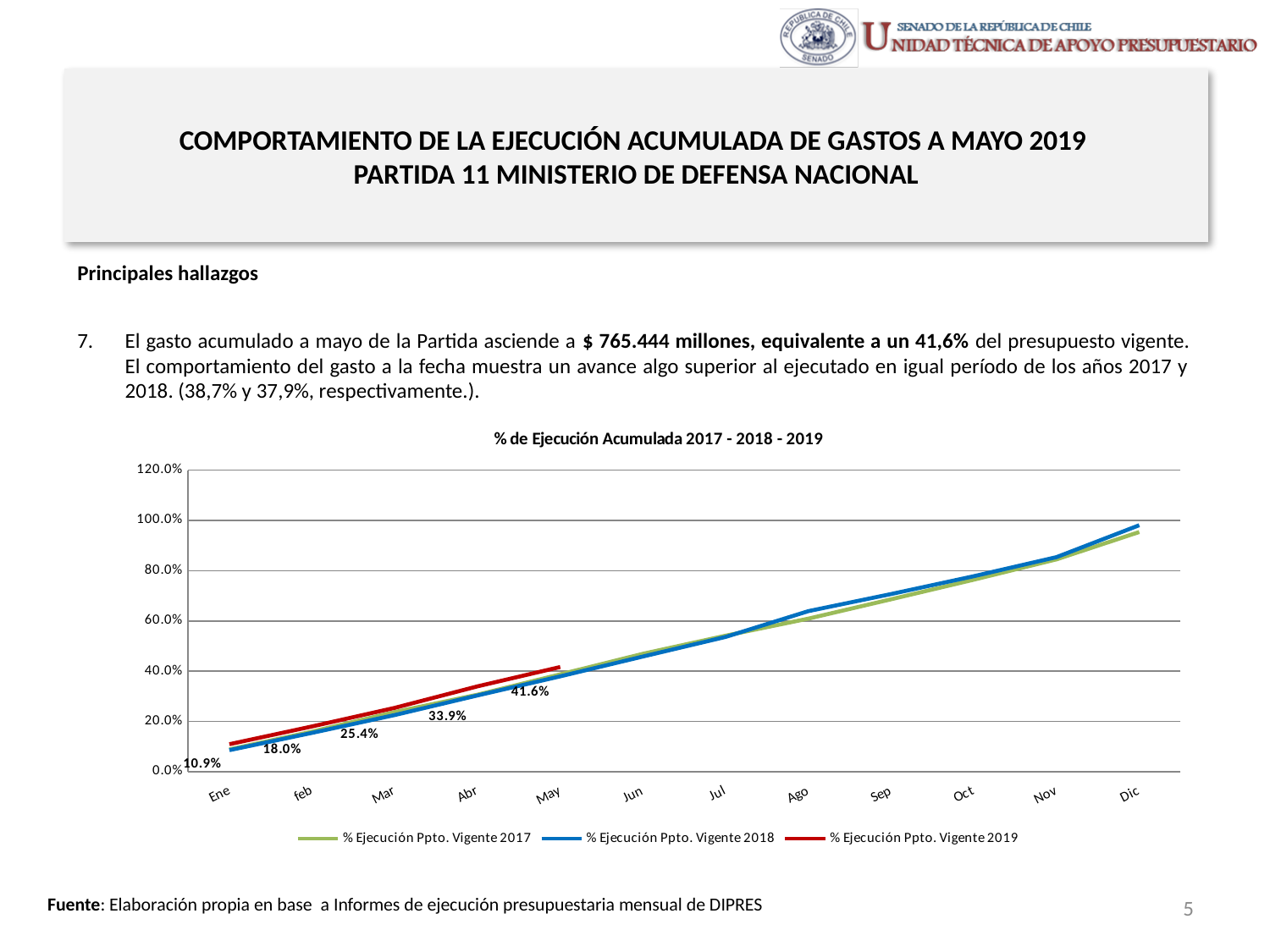
What is the value of % Ejecución Ppto. Vigente 2019 for Mar? 25.4% What is the difference between the 2019 values for Abr and Mar? 8.5% What is the difference between the 2019 values for May and Ene? 30.7% What is the title of the chart? % de Ejecución Acumulada 2017 - 2018 - 2019 How many months are shown on the x axis? 12 Does the % Ejecución Ppto. Vigente 2018 series rise or fall from Ene to Dic? rise What is the value of % Ejecución Ppto. Vigente 2019 for Ene? 10.9% What kind of chart is shown on the slide? line chart Is the value for % Ejecución Ppto. Vigente 2018 in Dic greater or less than 80%? greater What is the value of % Ejecución Ppto. Vigente 2019 for May? 41.6% How many series does the chart legend list? 3 Is the value for % Ejecución Ppto. Vigente 2017 in Dic greater or less than 100%? less